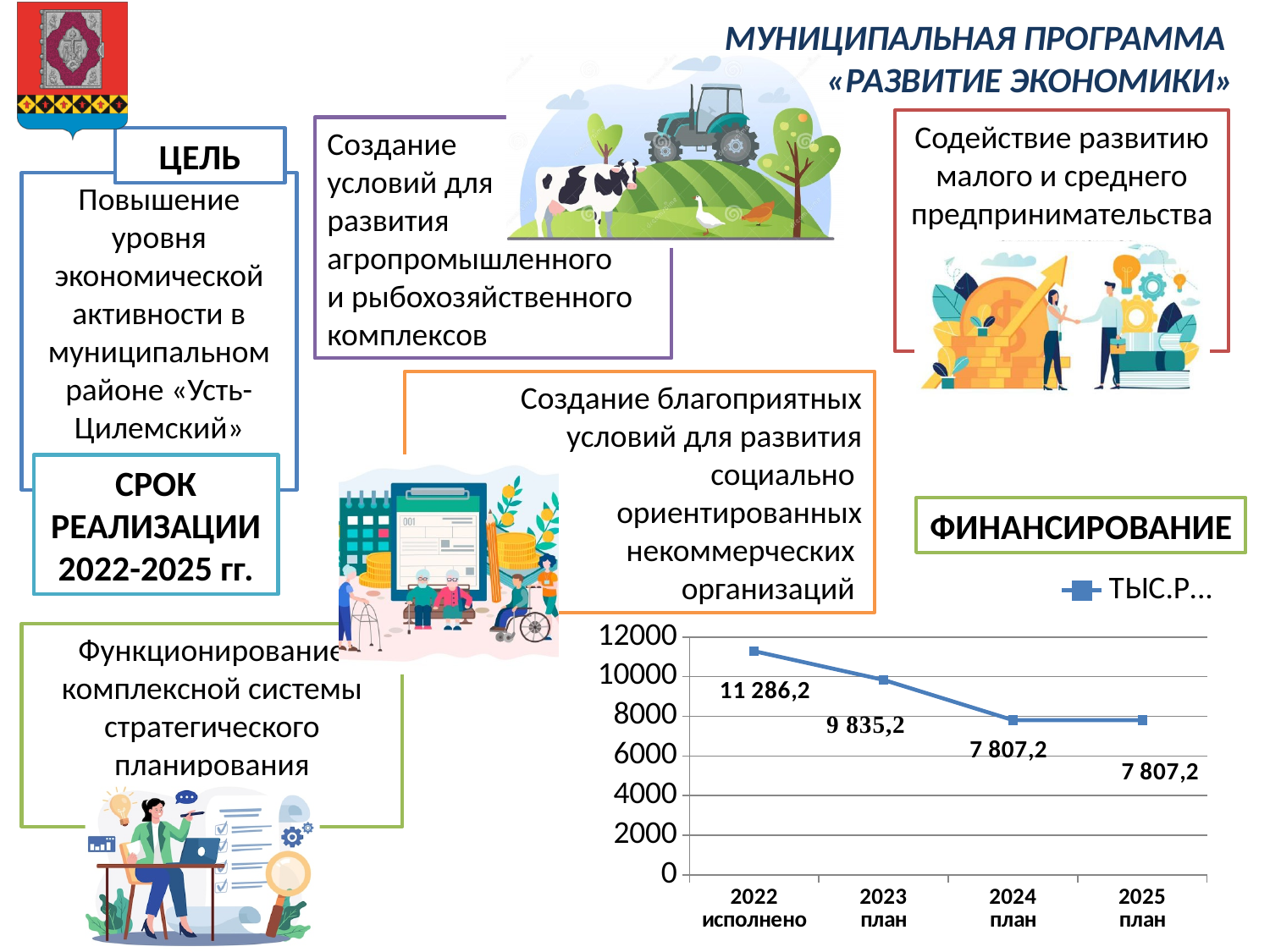
What type of chart is shown under the heading ФИНАНСИРОВАНИЕ? line chart Is the value for 2023 план greater or less than 10000? less What is the value for 2025 план? 7 807,2 What is the difference between the values for 2022 исполнено and 2023 план? 1 451,0 Which is larger, the value for 2022 исполнено or the value for 2024 план? 2022 исполнено Which year has the highest value on the chart? 2022 исполнено What is the value for 2023 план? 9 835,2 How many data points are plotted on the chart? 4 What is the value for 2024 план? 7 807,2 What is the difference between the values for 2023 план and 2024 план? 2 028,0 Do the values rise or fall from 2022 to 2024 along the x axis? fall What is the value for 2022 исполнено? 11 286,2